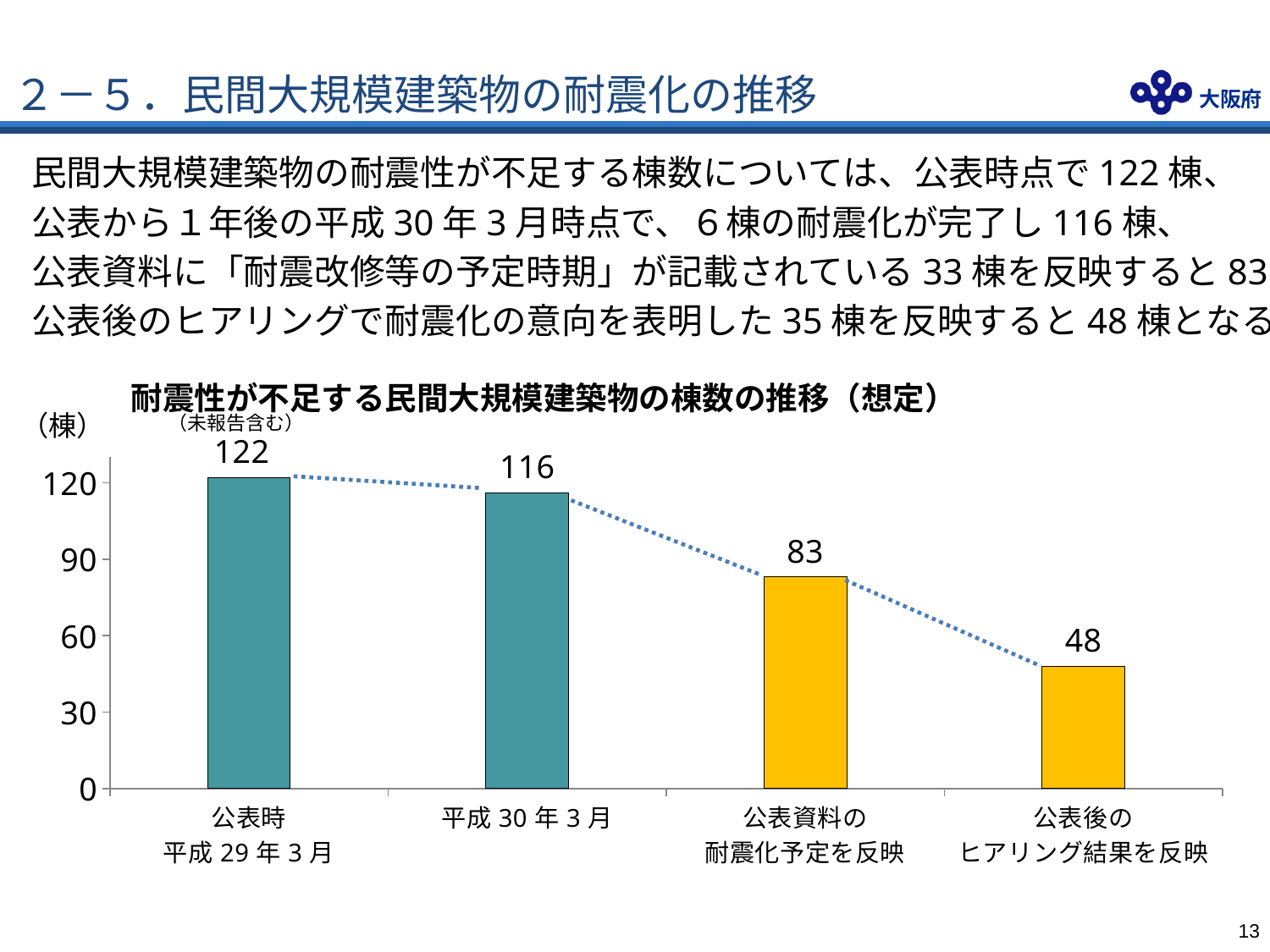
Which category has the highest value? 公表時 平成29年3月 What is the difference between the values for 公表資料の耐震化予定を反映 and 公表後のヒアリング結果を反映? 35 Do the values rise or fall from left to right along the x axis? fall How many categories are shown on the x axis? 4 What is the value for 公表後のヒアリング結果を反映? 48 What is the difference between the values for 公表時 平成29年3月 and 平成30年3月? 6 What kind of chart is this? bar chart What is the value for 平成30年3月? 116 What is the value for 公表資料の耐震化予定を反映? 83 Which is larger, the value for 平成30年3月 or the value for 公表資料の耐震化予定を反映? 平成30年3月 What is the value for 公表時 平成29年3月? 122 Which category has the lowest value? 公表後のヒアリング結果を反映